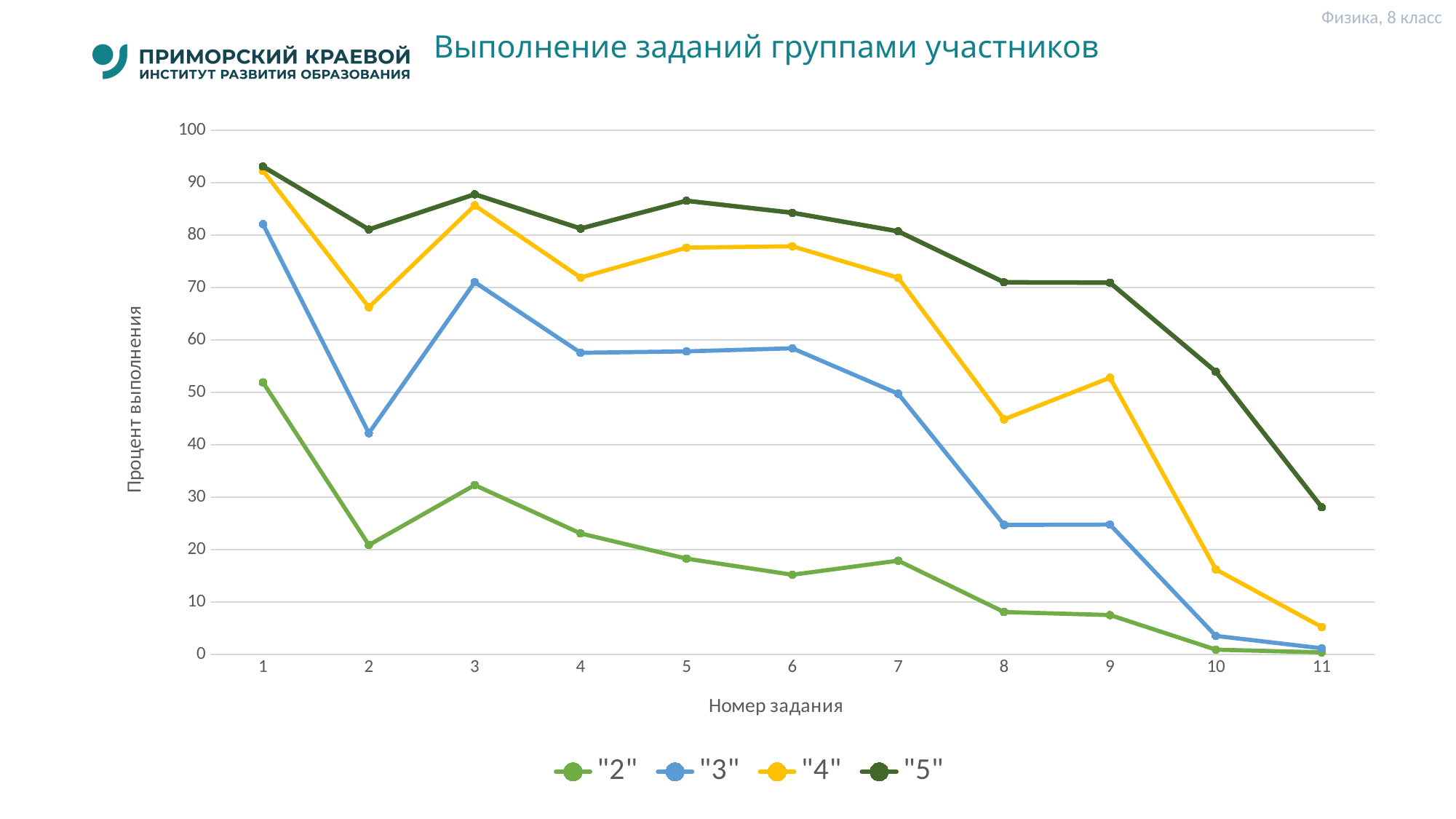
Is the value for series "4" at task 10 greater or less than 20? less What is the title of the y axis? Процент выполнения For series "4", at which task number is the value lowest? 11 Is the value for series "2" at task 2 greater or less than 30? less For series "5", at which task number is the value highest? 1 Do the values for series "5" rise or fall from task 7 to task 11? fall What kind of chart is shown on the slide? line chart Is the value for series "3" at task 3 greater or less than 60? greater At task 9, which series has the larger value, "4" or "3"? "4" How many task numbers are plotted along the x axis? 11 How many series does the legend list? 4